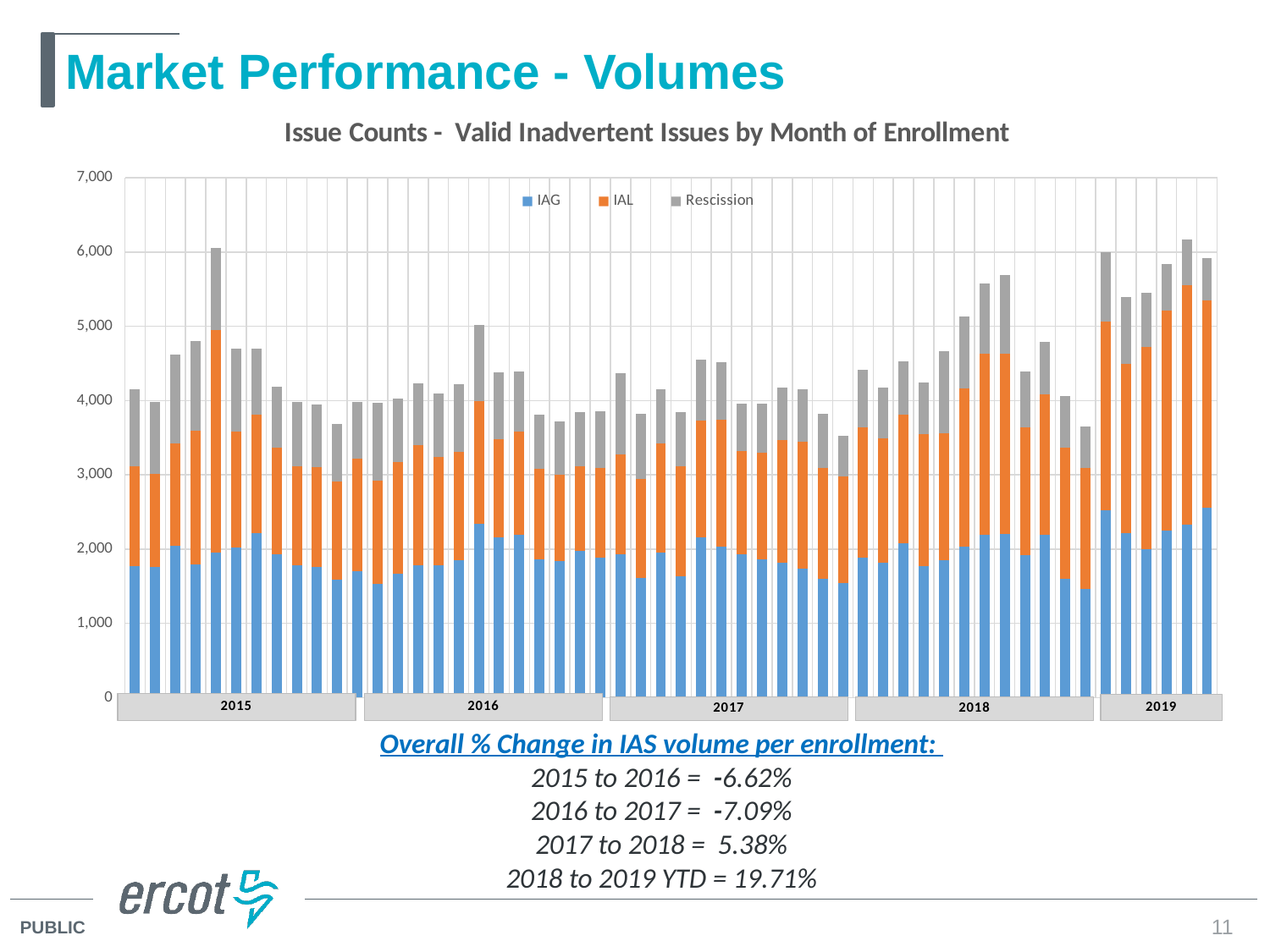
Which year group contains a taller maximum stacked bar, 2017 or 2019? 2019 Is the tallest stacked bar in the 2018 group greater or less than 5,000? greater How many year groups are labeled along the x axis of the chart? 5 What is the title of the chart? Issue Counts - Valid Inadvertent Issues by Month of Enrollment Which year group contains a taller maximum stacked bar, 2015 or 2016? 2015 How many series does the chart legend list? 3 What are the three series named in the chart legend? IAG, IAL, Rescission Is the tallest stacked bar in the 2017 group greater or less than 5,000? less Is the tallest stacked bar in the 2019 group greater or less than 6,000? greater What type of chart is shown on the slide? Stacked bar chart